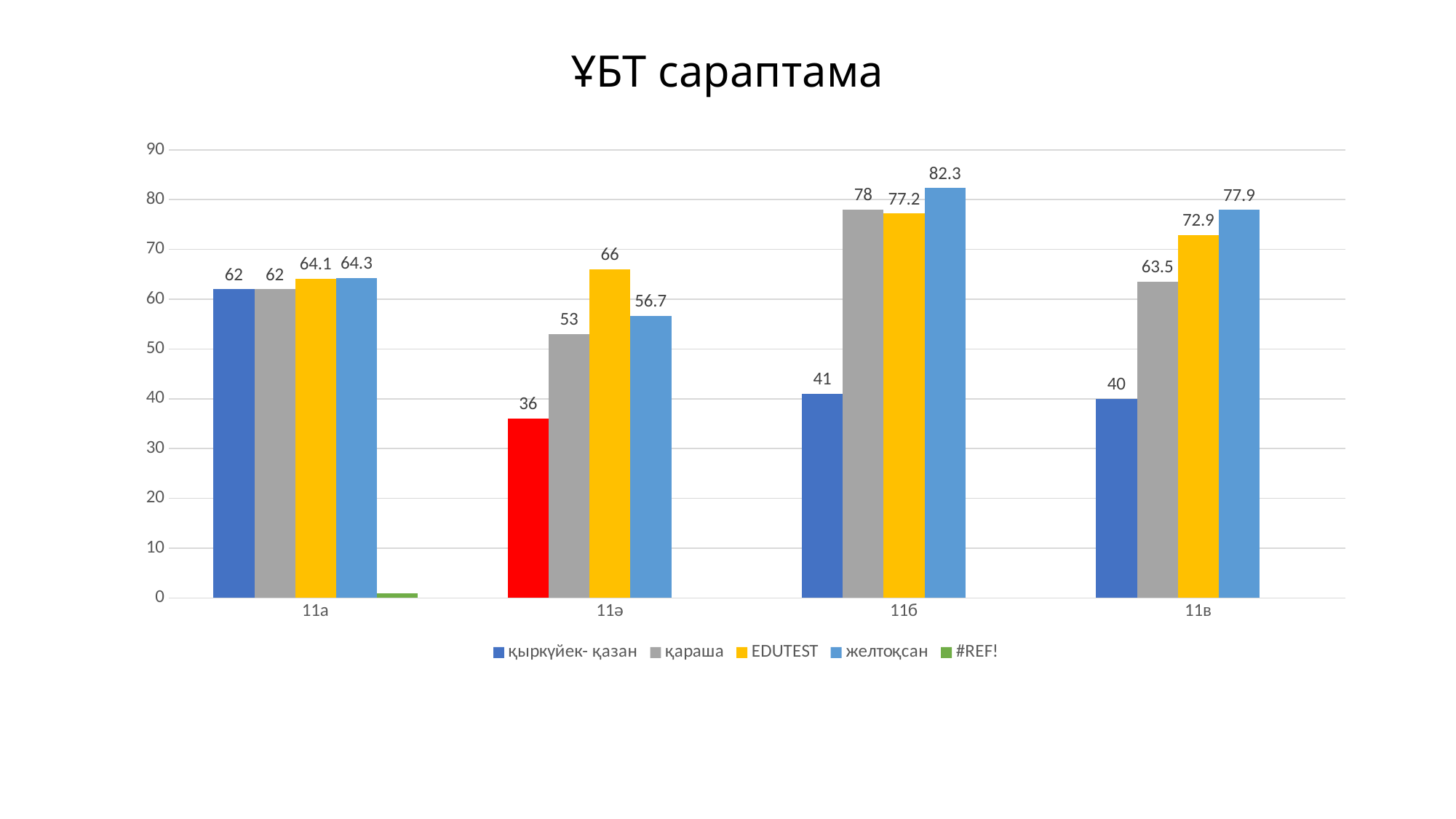
How many series does the legend list? 5 What is the қараша value for 11а? 62 What is the EDUTEST value for 11в? 72.9 Is the қараша value for 11б greater or less than 70? greater What is the difference between the желтоқсан and қыркүйек- қазан values for 11в? 37.9 Which is larger for 11ә: the EDUTEST value or the желтоқсан value? EDUTEST Which category has the highest желтоқсан value? 11б What is the value for 11б in the желтоқсан series? 82.3 What is the title of the chart? ҰБТ сараптама Which category has the lowest қыркүйек- қазан value? 11ә How many categories are shown on the x axis? 4 What is the value for 11ә in the қыркүйек- қазан series? 36